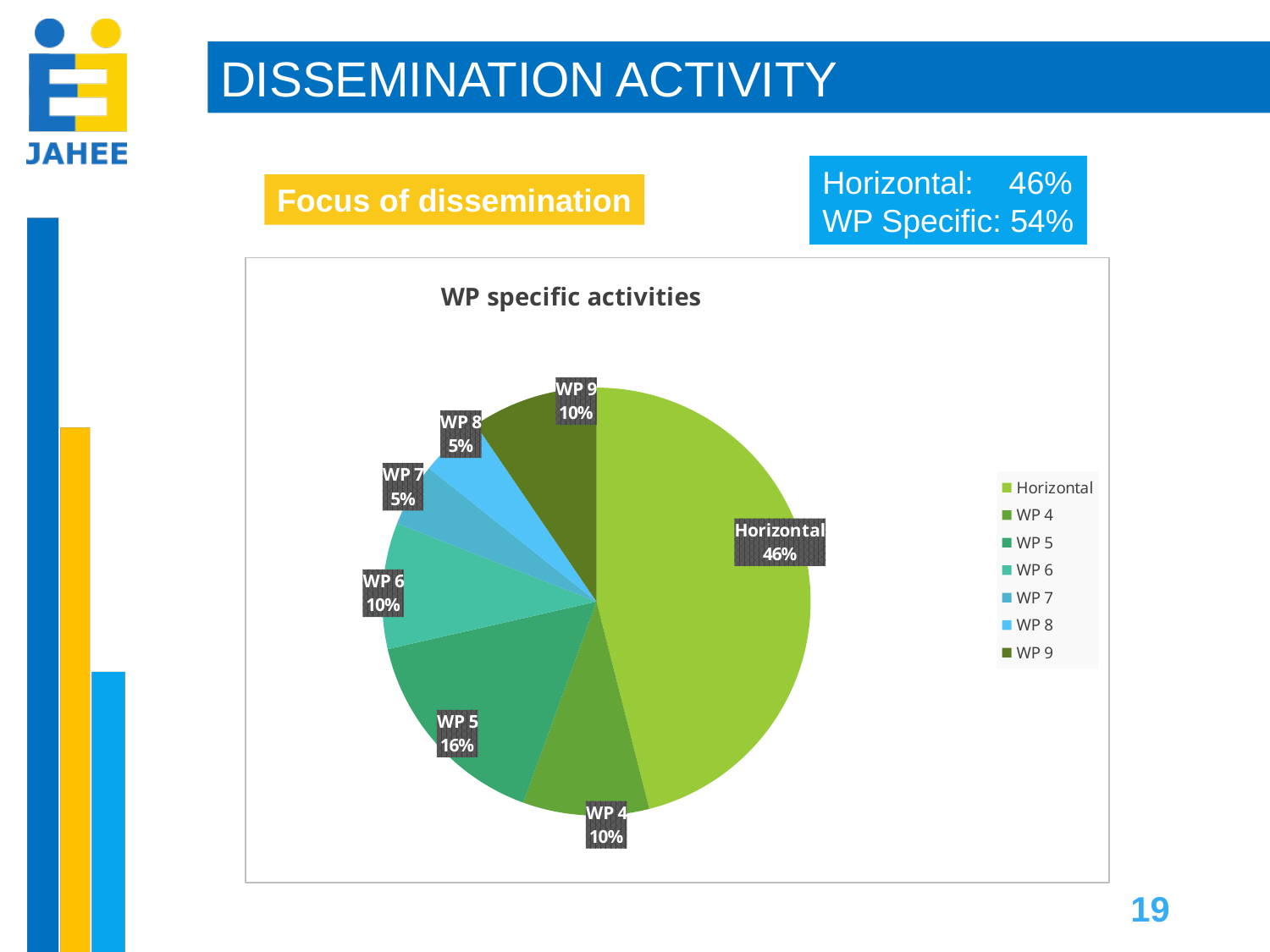
What kind of chart is shown on the slide? pie chart How many entries does the legend list? 7 Which of WP 4 and WP 9 has the larger share? They are equal (10%) What is the difference between the Horizontal share and the WP 5 share? 30% How many slices does the pie chart have? 7 What is the value for WP 8? 5% Which slice of the pie is the largest? Horizontal Which of WP 5 and WP 6 has the larger share? WP 5 What is the title of the chart? WP specific activities What is the combined share of WP 7 and WP 8? 10% What is the value for WP 5? 16% What share of the pie does Horizontal take? 46%